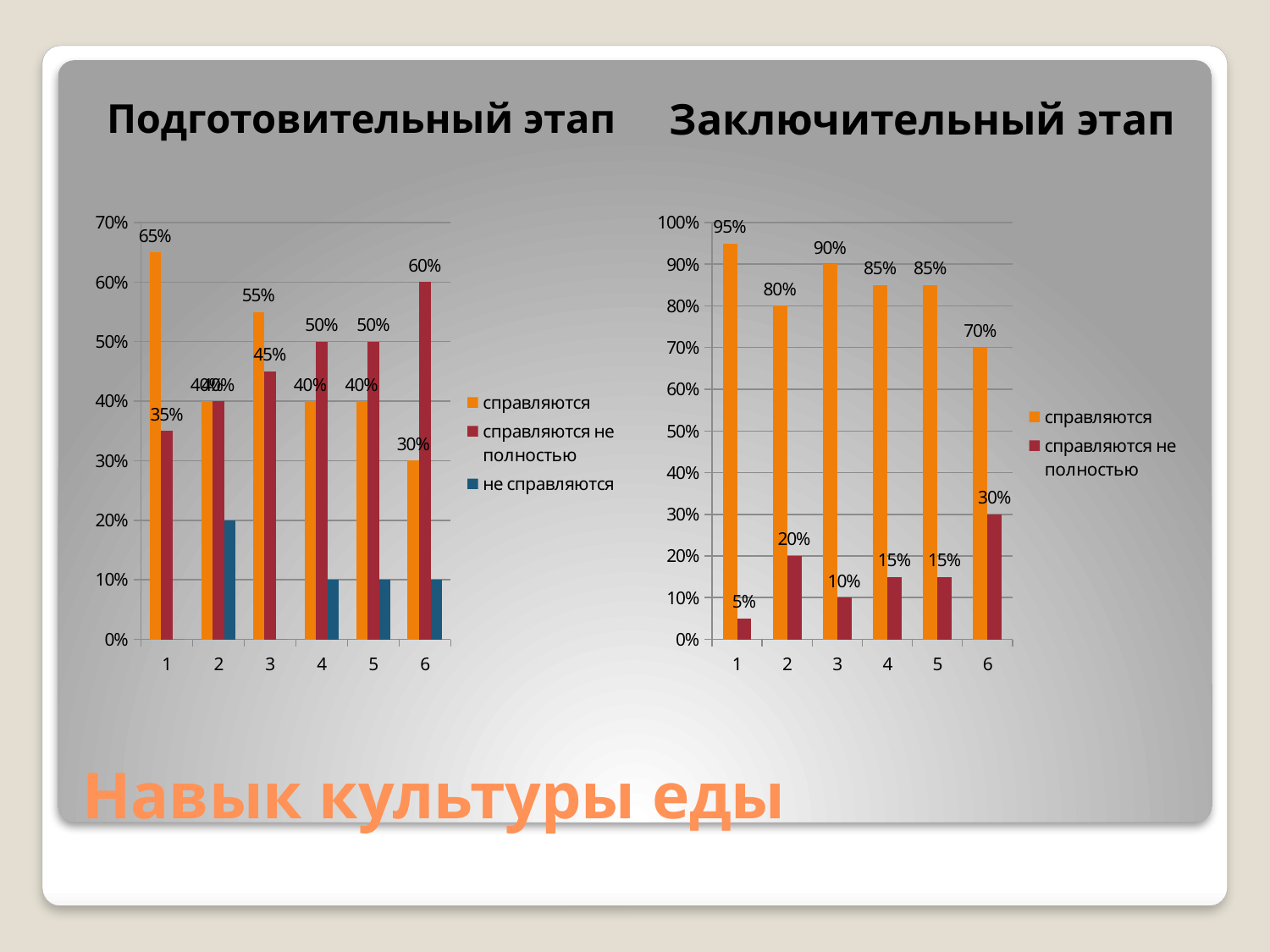
How many categories are shown on the x axis of the chart titled Заключительный этап? 6 In the chart titled Заключительный этап, which category has the highest value for справляются не полностью? 6 In the chart titled Подготовительный этап, which category has the lowest value for справляются? 6 In the chart titled Подготовительный этап, what is the value for справляются at category 3? 55% In the chart titled Заключительный этап, which is larger for справляются: category 2 or category 3? category 3 In the chart titled Подготовительный этап, is the value for не справляются at category 2 greater or less than 10%? greater How many series does the legend of the chart titled Подготовительный этап list? 3 How many series does the legend of the chart titled Заключительный этап list? 2 In the chart titled Подготовительный этап, do the values for справляются не полностью rise or fall from category 1 to category 6? rise In the chart titled Подготовительный этап, what is the difference between справляются and справляются не полностью at category 1? 30% In the chart titled Заключительный этап, what is the value for справляются at category 1? 95% What kind of chart is the chart titled Заключительный этап? bar chart